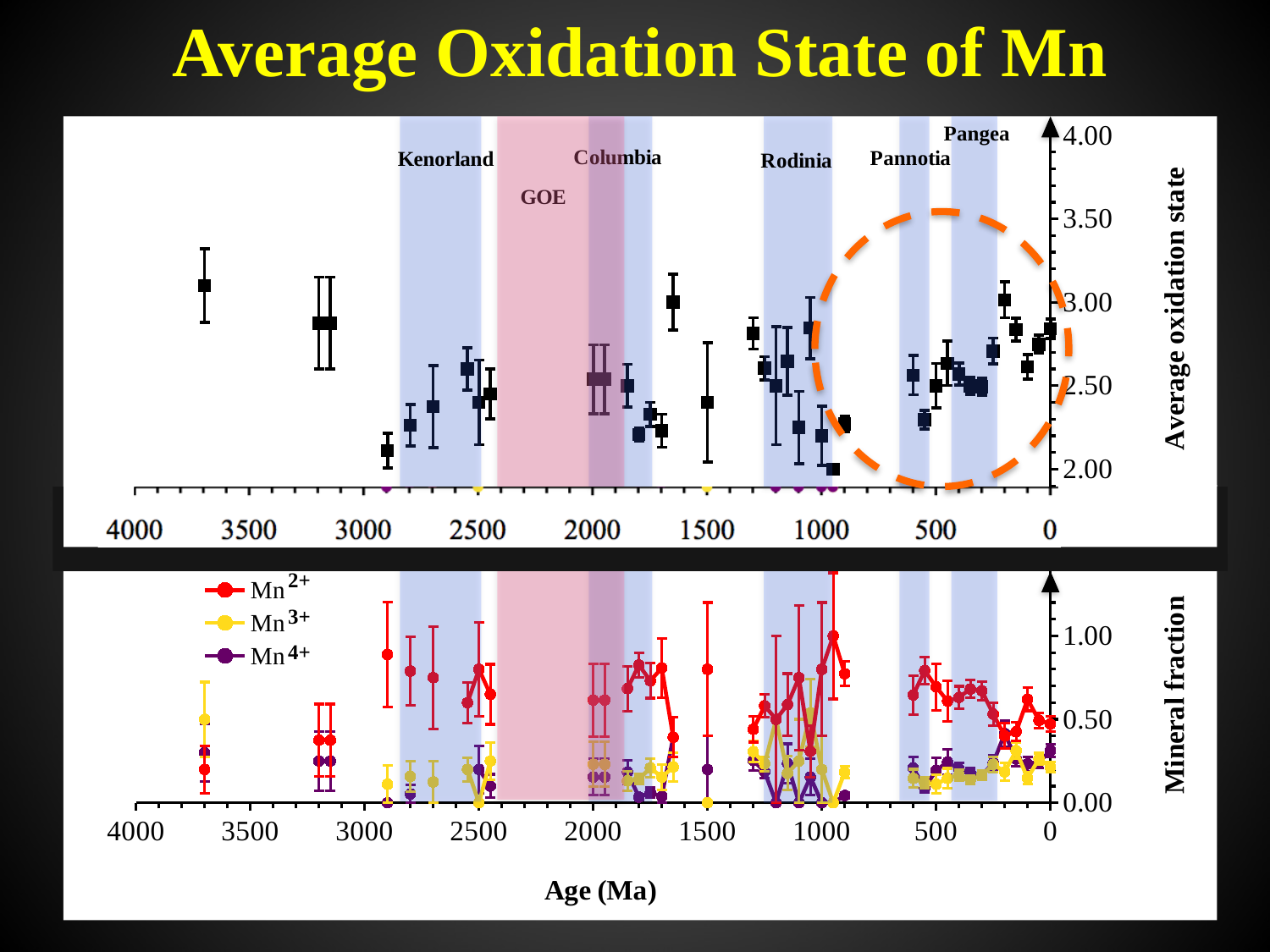
What is the label of the shared x axis at the bottom of the slide? Age (Ma) In the bottom chart (Mineral fraction), which series has the larger value at about 2900 Ma, Mn2+ or Mn3+? Mn2+ What are the series names in the legend of the bottom chart (Mineral fraction)? Mn2+, Mn3+, Mn4+ In the bottom chart (Mineral fraction), is the Mn2+ value at about 1000 Ma greater or less than 0.50? greater In the bottom chart (Mineral fraction), is the Mn2+ value at about 2900 Ma greater or less than 0.50? greater In the top chart (Average oxidation state), is the value for the point at about 3700 Ma greater or less than 2.50? greater In the bottom chart (Mineral fraction), which series has the lowest value at about 1500 Ma? Mn3+ What kind of chart is the top chart on the slide? scatter plot In the bottom chart (Mineral fraction), which series has the highest value at about 1000 Ma? Mn2+ How many series does the legend of the bottom chart (Mineral fraction) list? 3